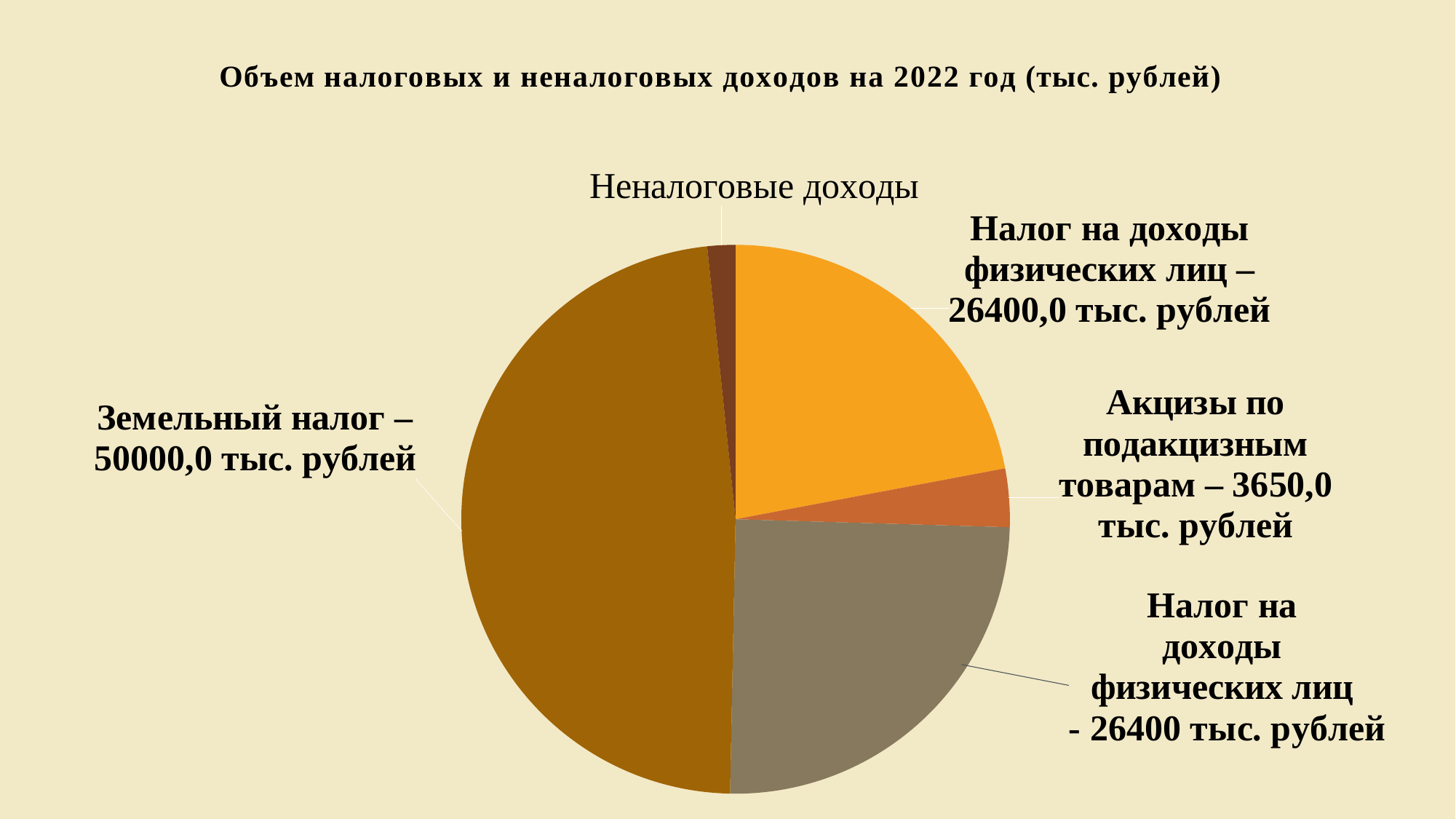
Which is larger: Земельный налог or Акцизы по подакцизным товарам? Земельный налог What is the value shown for Земельный налог? 50000,0 тыс. рублей Which slice of the pie has no value printed in its label? Неналоговые доходы Which category has the smallest slice of the pie? Неналоговые доходы What is the value shown for Акцизы по подакцизным товарам? 3650,0 тыс. рублей How many slices does the pie chart have? 5 Is the value for Акцизы по подакцизным товарам greater or less than the value for Земельный налог? less What is the difference between Земельный налог (50000,0) and the orange slice Налог на доходы физических лиц (26400,0)? 23600,0 тыс. рублей What type of chart is shown on the slide? Pie chart Which category has the largest slice of the pie? Земельный налог What is the title of the chart? Объем налоговых и неналоговых доходов на 2022 год (тыс. рублей) What is the difference between Земельный налог and Акцизы по подакцизным товарам? 46350,0 тыс. рублей